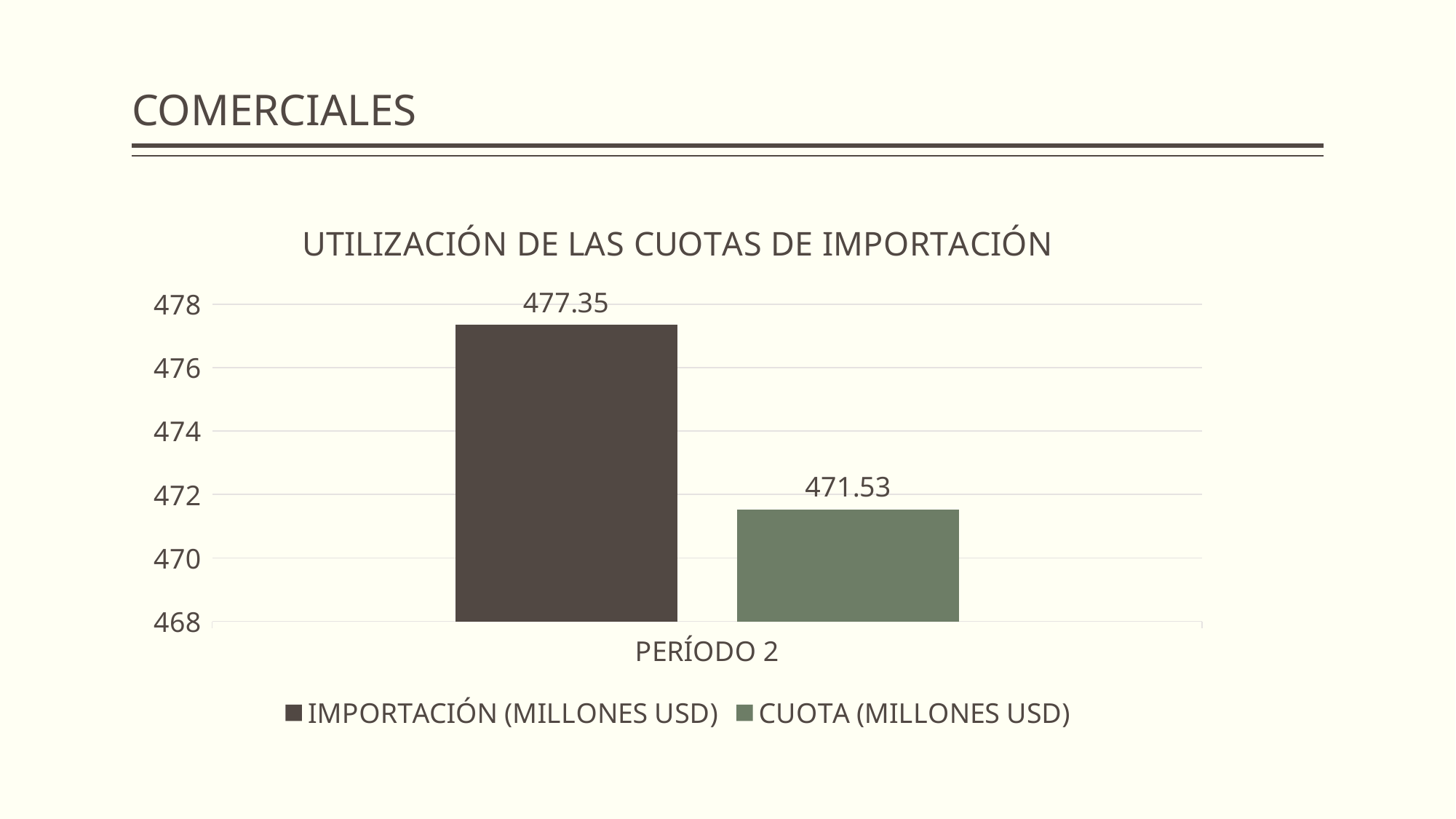
What is the title of the chart? UTILIZACIÓN DE LAS CUOTAS DE IMPORTACIÓN What is the difference between the IMPORTACIÓN (MILLONES USD) and CUOTA (MILLONES USD) values for PERÍODO 2? 5.82 How many categories are shown on the x axis? 1 What is the label of the category on the x axis? PERÍODO 2 What is the value of IMPORTACIÓN (MILLONES USD) for PERÍODO 2? 477.35 What kind of chart is shown on the slide? bar chart Is the value for IMPORTACIÓN (MILLONES USD) greater or less than 476? greater What is the value of CUOTA (MILLONES USD) for PERÍODO 2? 471.53 Which series has the higher value for PERÍODO 2, IMPORTACIÓN (MILLONES USD) or CUOTA (MILLONES USD)? IMPORTACIÓN (MILLONES USD) Is the value for CUOTA (MILLONES USD) greater or less than 472? less How many series does the legend list? 2 Which series has the lowest value in the chart? CUOTA (MILLONES USD)